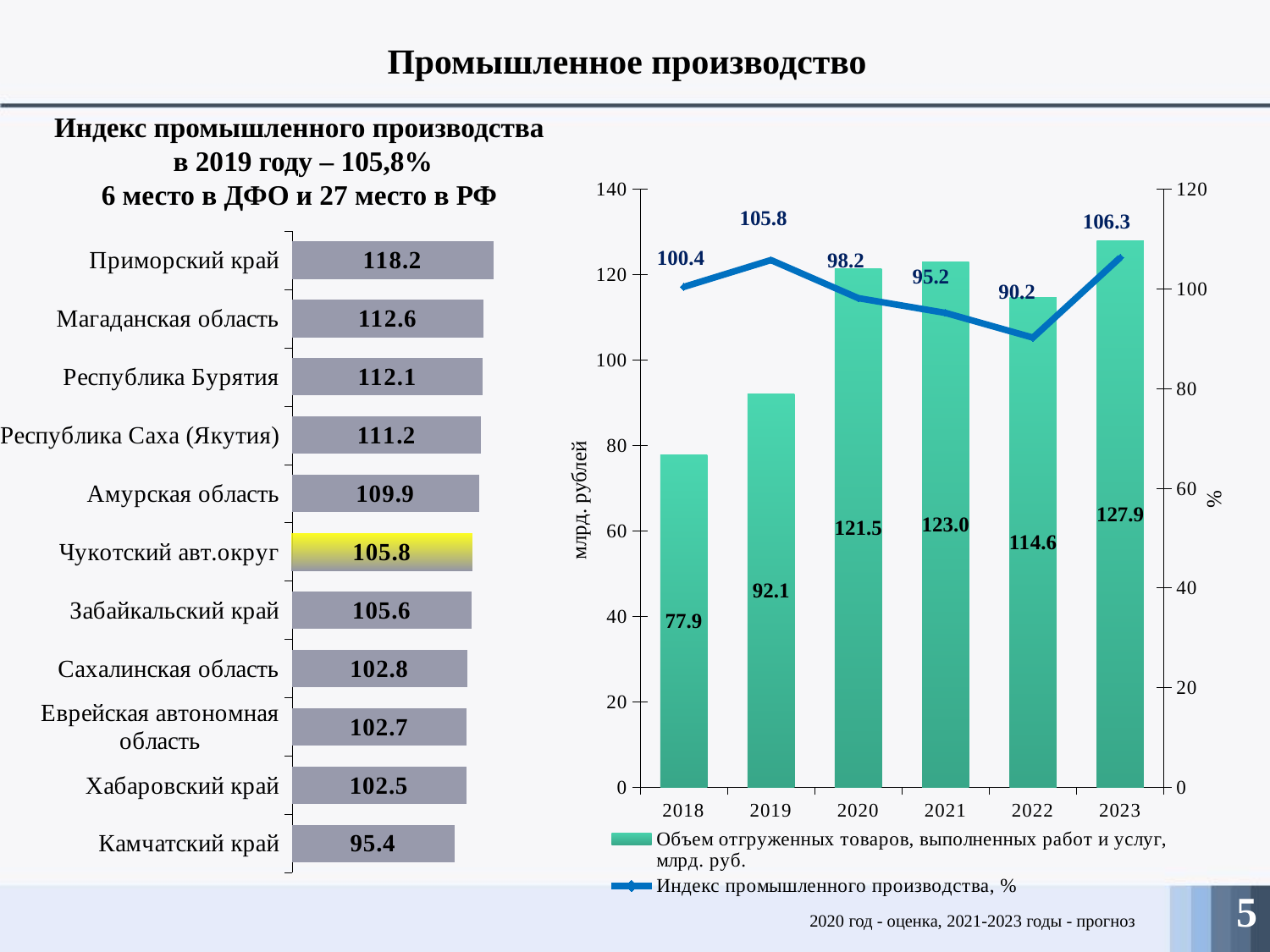
On the right chart, what is the difference between the bar values for 2023 and 2018? 50.0 On the right chart, do the bar values rise or fall from 2018 to 2021? rise On the right chart, what is the value of the bar for 2023? 127.9 On the left chart, what is the value for Приморский край? 118.2 On the left chart, what is the difference between the values for Приморский край and Камчатский край? 22.8 On the left chart, which region has the lowest value? Камчатский край On the left chart, how many regions are shown? 11 On the right chart, how many series does the legend list? 2 On the left chart, which region's bar is highlighted in yellow? Чукотский авт.округ On the right chart, which year has the lowest bar value? 2018 On the right chart, what is the value of the line (Индекс промышленного производства, %) for 2022? 90.2 On the left chart, which region has the highest value? Приморский край